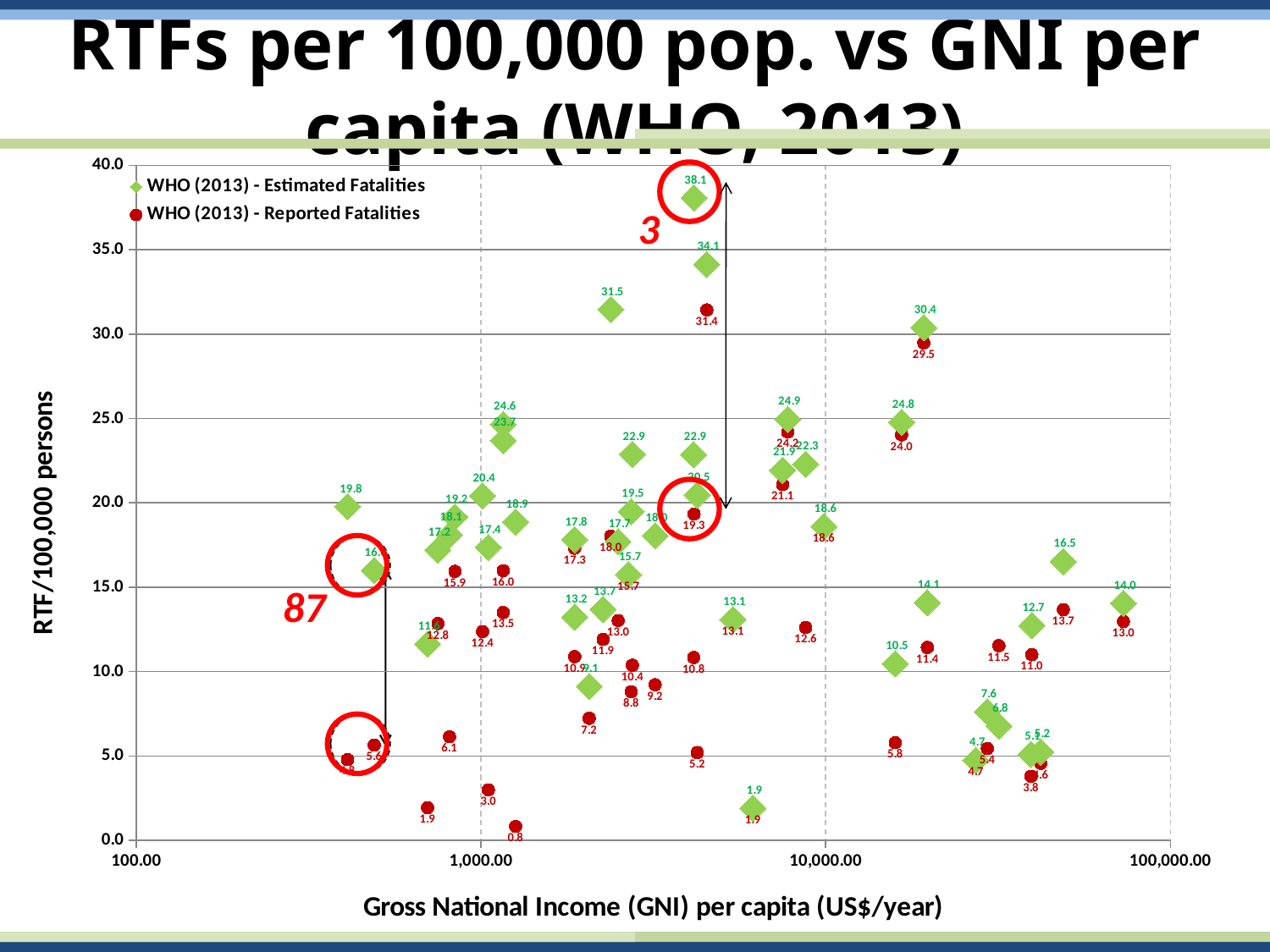
Which is larger: the highest Estimated Fatalities value or the highest Reported Fatalities value? Estimated Fatalities (38.1) Is the highest Estimated Fatalities point greater or less than 35.0? greater What is the lowest value plotted for the WHO (2013) - Reported Fatalities series? 0.8 What kind of chart is shown on the slide? Scatter chart What is the lowest value plotted for the WHO (2013) - Estimated Fatalities series? 1.9 How many series does the legend list? 2 What is the value of the Estimated Fatalities point circled and annotated with the number 3? 38.1 What are the two series named in the legend? WHO (2013) - Estimated Fatalities; WHO (2013) - Reported Fatalities What is the title of the x axis? Gross National Income (GNI) per capita (US$/year) What is the highest value plotted for the WHO (2013) - Estimated Fatalities series? 38.1 What is the difference between the two highest Estimated Fatalities values, 38.1 and 34.1? 4.0 What is the highest value plotted for the WHO (2013) - Reported Fatalities series? 31.4